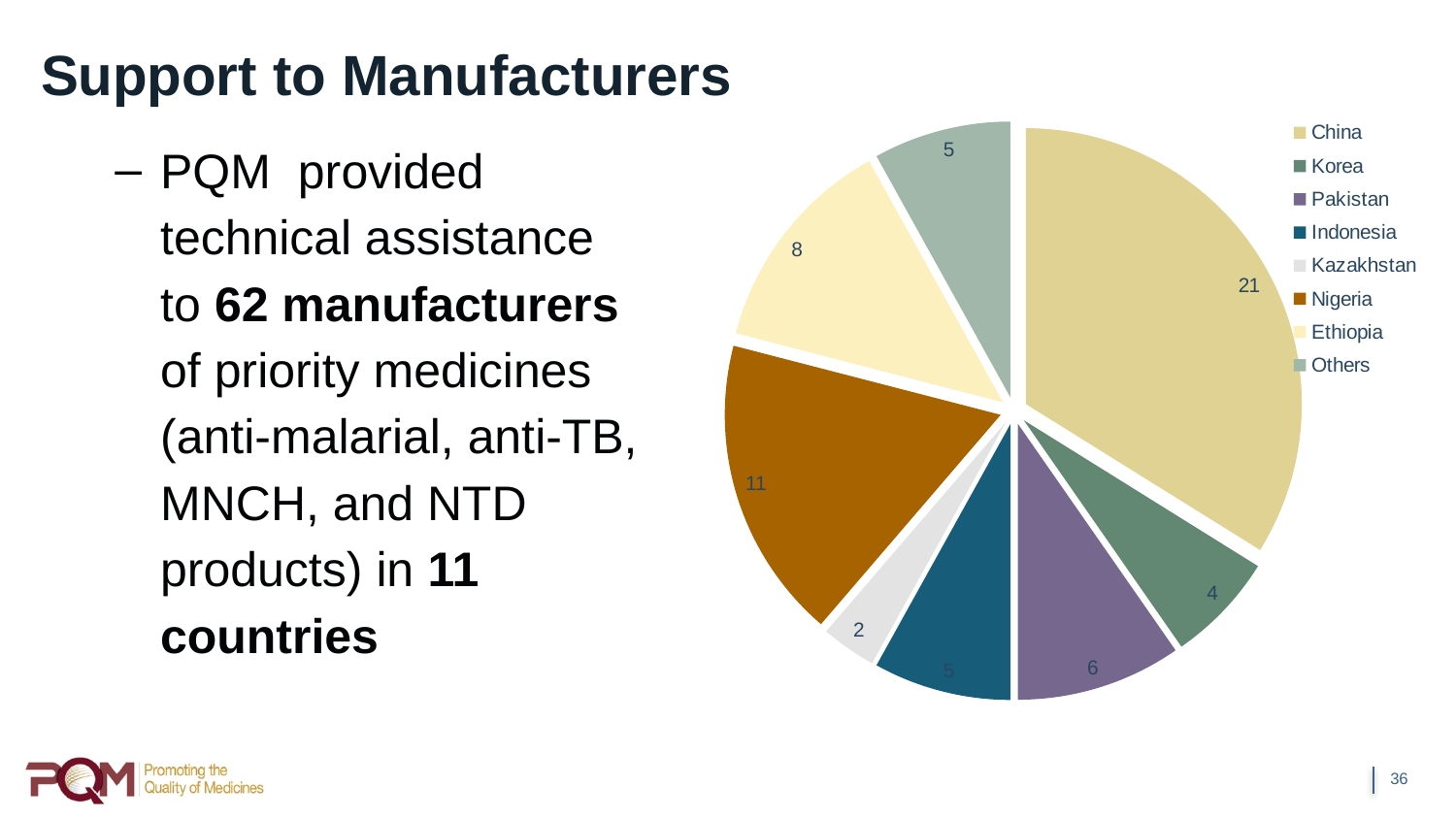
What is the value for Ethiopia in the pie chart? 8 What type of chart is shown on the slide? Pie chart What is the value for Kazakhstan in the pie chart? 2 Which is larger, the value for Pakistan or the value for Korea? Pakistan What is the total of all slices in the pie chart? 62 What is the difference between the values for China and Nigeria? 10 Which category has the smallest slice in the pie chart? Kazakhstan Which category has the largest slice in the pie chart? China What is the value for Nigeria in the pie chart? 11 How many categories does the pie chart's legend list? 8 What is the value for China in the pie chart? 21 Which legend entry is shown in the dark orange-brown colour? Nigeria